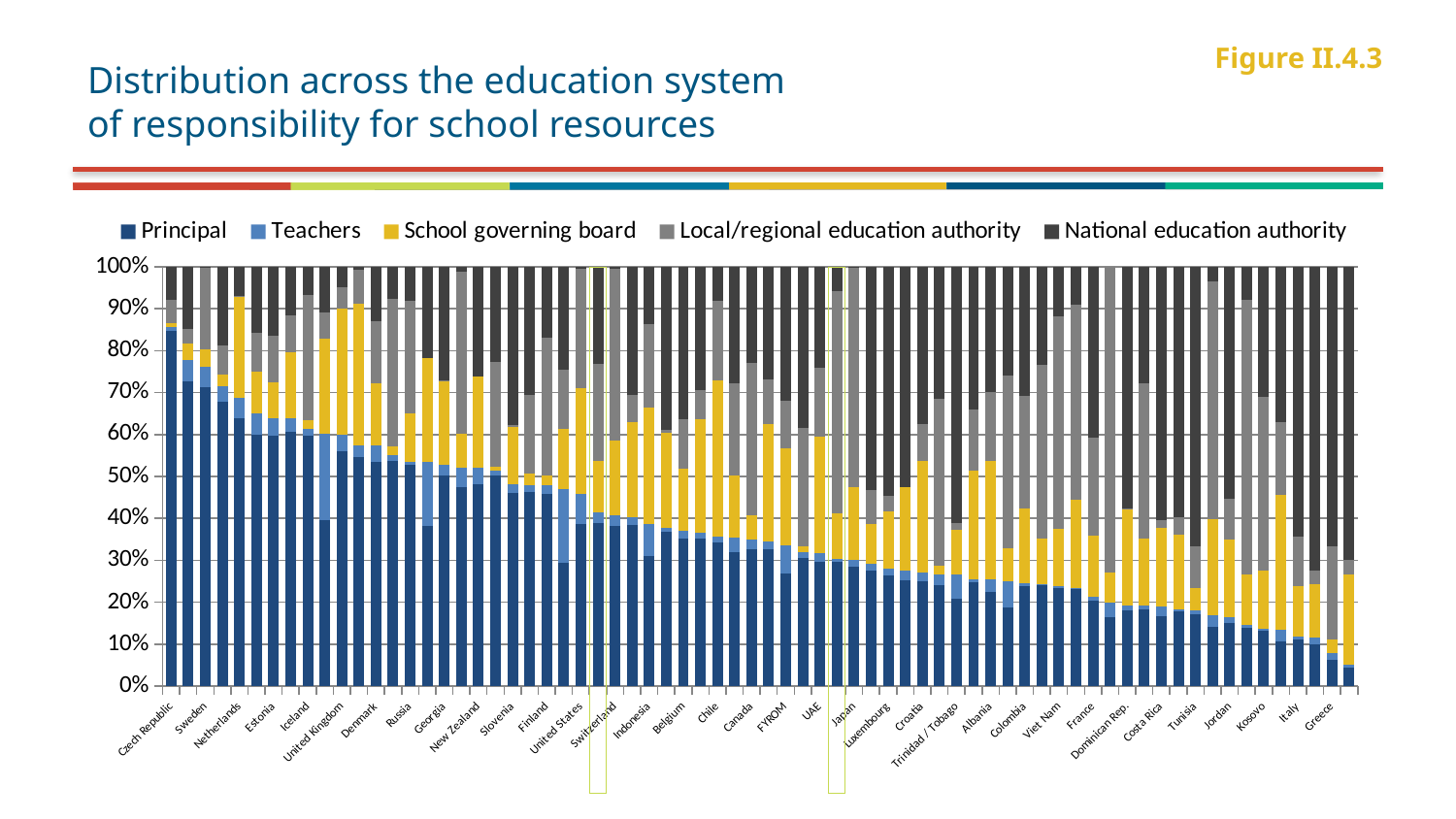
How many series does the legend list? 5 Which has a larger Principal share, the Czech Republic or Greece? Czech Republic Is the Principal value for the Czech Republic greater or less than 80%? greater What kind of chart is shown on the slide? Stacked bar chart Does the Principal share rise or fall moving from left to right along the x axis? Fall Which country has the highest Principal share? Czech Republic What do the five segments of each stacked bar add up to? 100% Is the Principal value for Japan greater or less than 40%? less What figure number is given for this chart? Figure II.4.3 What is the title of the chart on the slide? Distribution across the education system of responsibility for school resources Is the Principal value for Greece greater or less than 10%? less